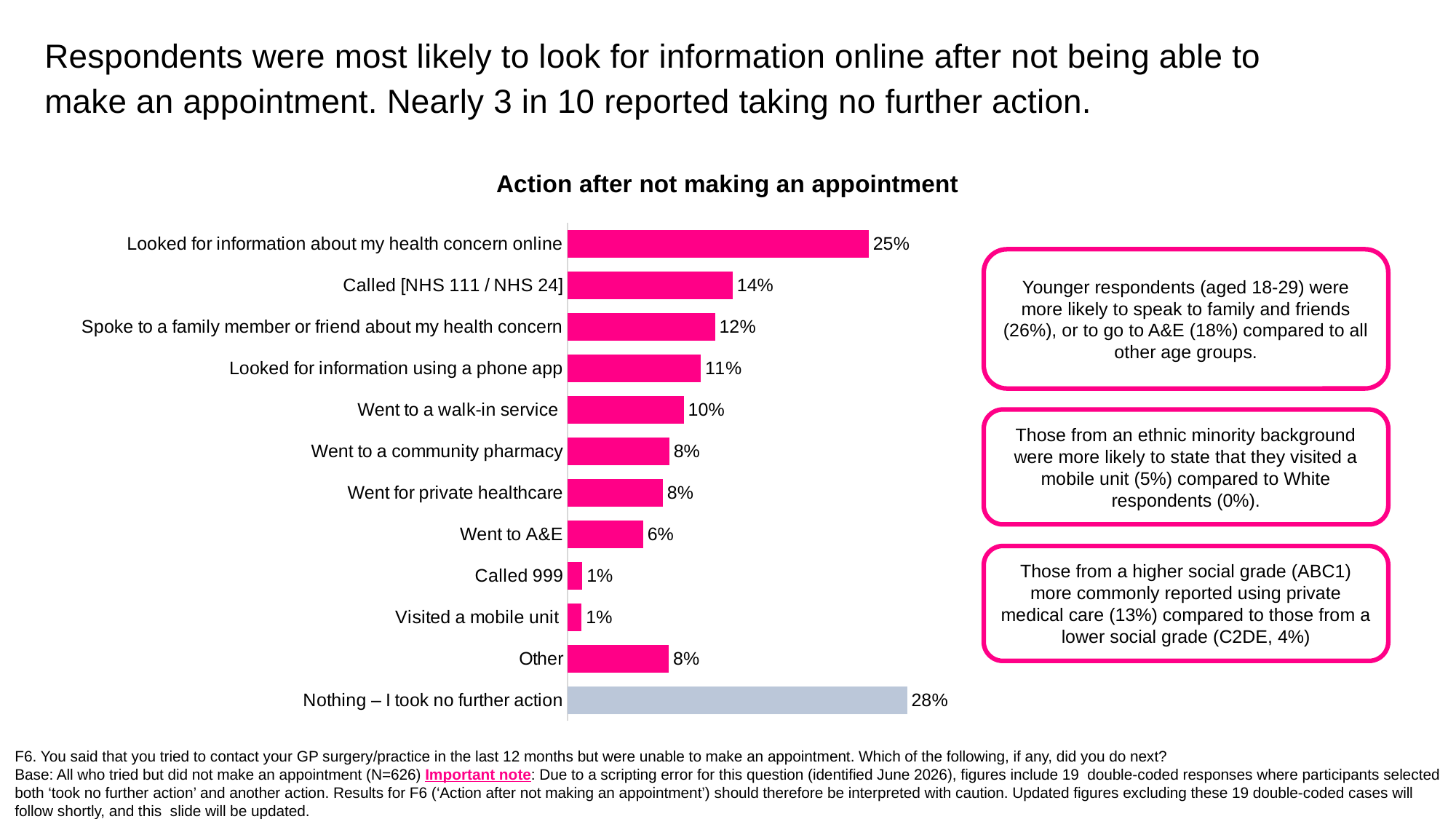
Which is larger: 'Went to a walk-in service' or 'Went to a community pharmacy'? Went to a walk-in service What is the value for 'Looked for information about my health concern online'? 25% What is the title of the chart? Action after not making an appointment What is the difference between 'Nothing – I took no further action' and 'Looked for information about my health concern online'? 3% What is the value for 'Nothing – I took no further action'? 28% How many categories are shown in the chart? 12 What percentage of respondents called NHS 111 / NHS 24? 14% Which category has the highest value in the chart? Nothing – I took no further action What is the value for 'Went to A&E'? 6% What is the difference between 'Looked for information about my health concern online' and 'Called [NHS 111 / NHS 24]'? 11% What type of chart is shown on the slide? Bar chart Which is larger: 'Spoke to a family member or friend about my health concern' or 'Looked for information using a phone app'? Spoke to a family member or friend about my health concern